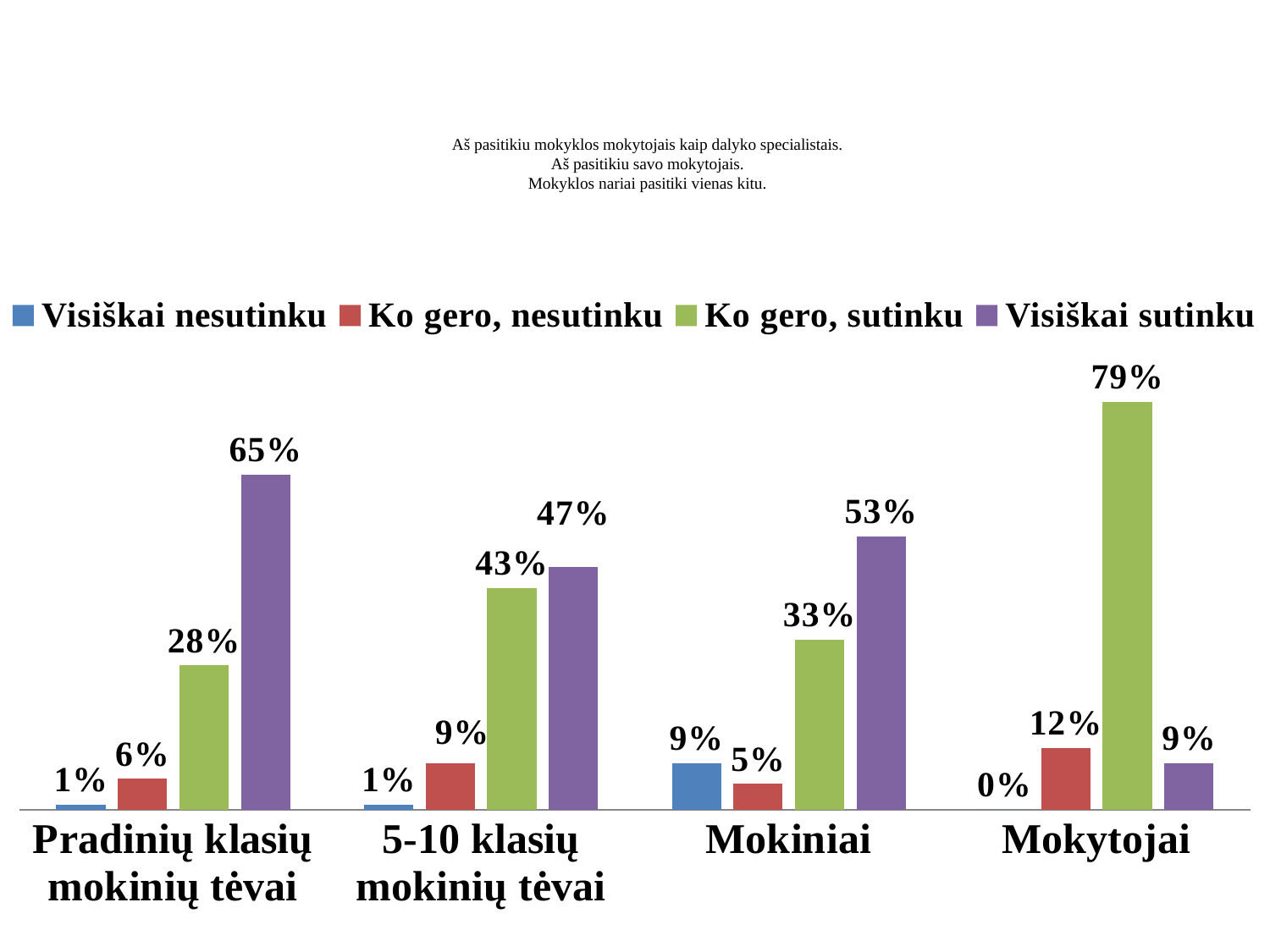
What colour represents the "Ko gero, sutinku" series? Green What is the value for "Ko gero, sutinku" in the "Mokytojai" category? 79% Which category has the lowest value for "Visiškai sutinku"? Mokytojai What is the value for "Visiškai sutinku" in the "Pradinių klasių mokinių tėvai" category? 65% How many categories are shown on the x axis? 4 Which category has the highest value for "Ko gero, sutinku"? Mokytojai What is the value for "Visiškai nesutinku" in the "Mokytojai" category? 0% What is the value for "Ko gero, nesutinku" in the "Mokiniai" category? 5% Which is larger in the "Mokiniai" category: "Visiškai sutinku" or "Ko gero, sutinku"? Visiškai sutinku What is the difference between "Visiškai sutinku" and "Ko gero, sutinku" in the "5-10 klasių mokinių tėvai" category? 4% How many series does the legend list? 4 What kind of chart is shown on the slide? Bar chart